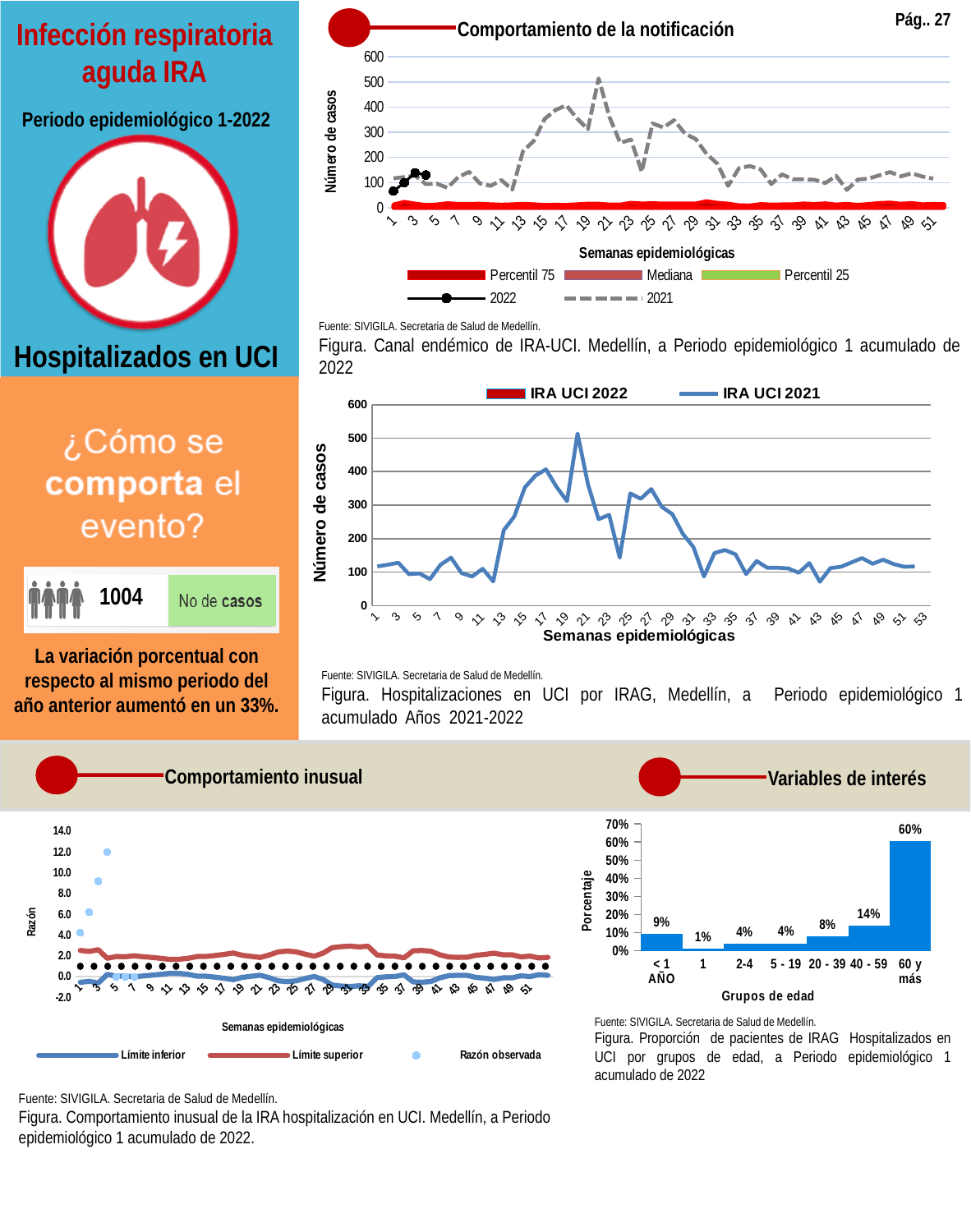
What type of chart is used for the proportion of IRAG patients by age group (bottom right)? Bar chart How many age groups are shown in the bar chart at the bottom right? 7 In the bar chart of IRAG patients hospitalized in UCI by age group (bottom right), what percentage corresponds to the '60 y más' group? 60% In the 'Hospitalizaciones en UCI por IRAG' chart (middle right), is the IRA UCI 2021 value at week 20 greater or less than 400? greater How many series does the legend of the 'Comportamiento inusual' chart (bottom left) list? 3 In the bar chart by age group (bottom right), which is larger: the value for '< 1 AÑO' or the value for '20 - 39'? < 1 AÑO How many series does the legend of the 'Canal endémico de IRA-UCI' chart (top right) list? 5 In the bar chart by age group (bottom right), what is the difference between the '60 y más' group and the '40 - 59' group? 46% In the bar chart by age group (bottom right), what percentage corresponds to the '40 - 59' group? 14% In the 'Hospitalizaciones en UCI por IRAG' chart (middle right), what is the label of the y axis? Número de casos In the bar chart by age group (bottom right), which age group has the highest percentage? 60 y más In the bar chart by age group (bottom right), which age group has the lowest percentage? 1